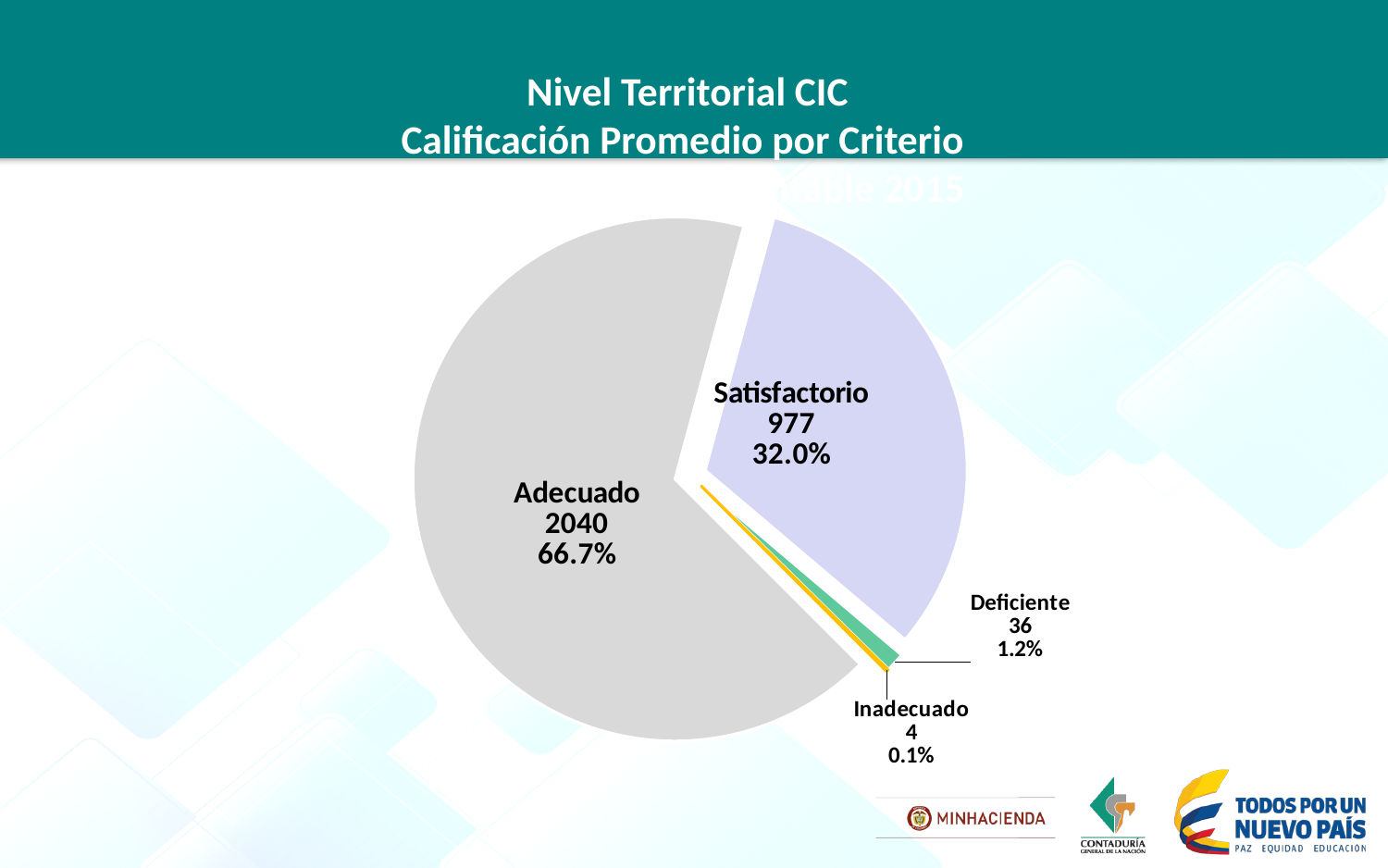
What share of the pie does Deficiente represent? 1.2% What share of the pie does Satisfactorio represent? 32.0% What is the value for Satisfactorio? 977 What kind of chart is shown on the slide? pie chart How many slices does the pie chart have? 4 What is the value for Deficiente? 36 Which is larger, the value for Deficiente or the value for Inadecuado? Deficiente Which category has the largest slice? Adecuado What is the value for Inadecuado? 4 Which category has the smallest slice? Inadecuado What is the difference between the values for Adecuado and Satisfactorio? 1063 What is the value for Adecuado? 2040